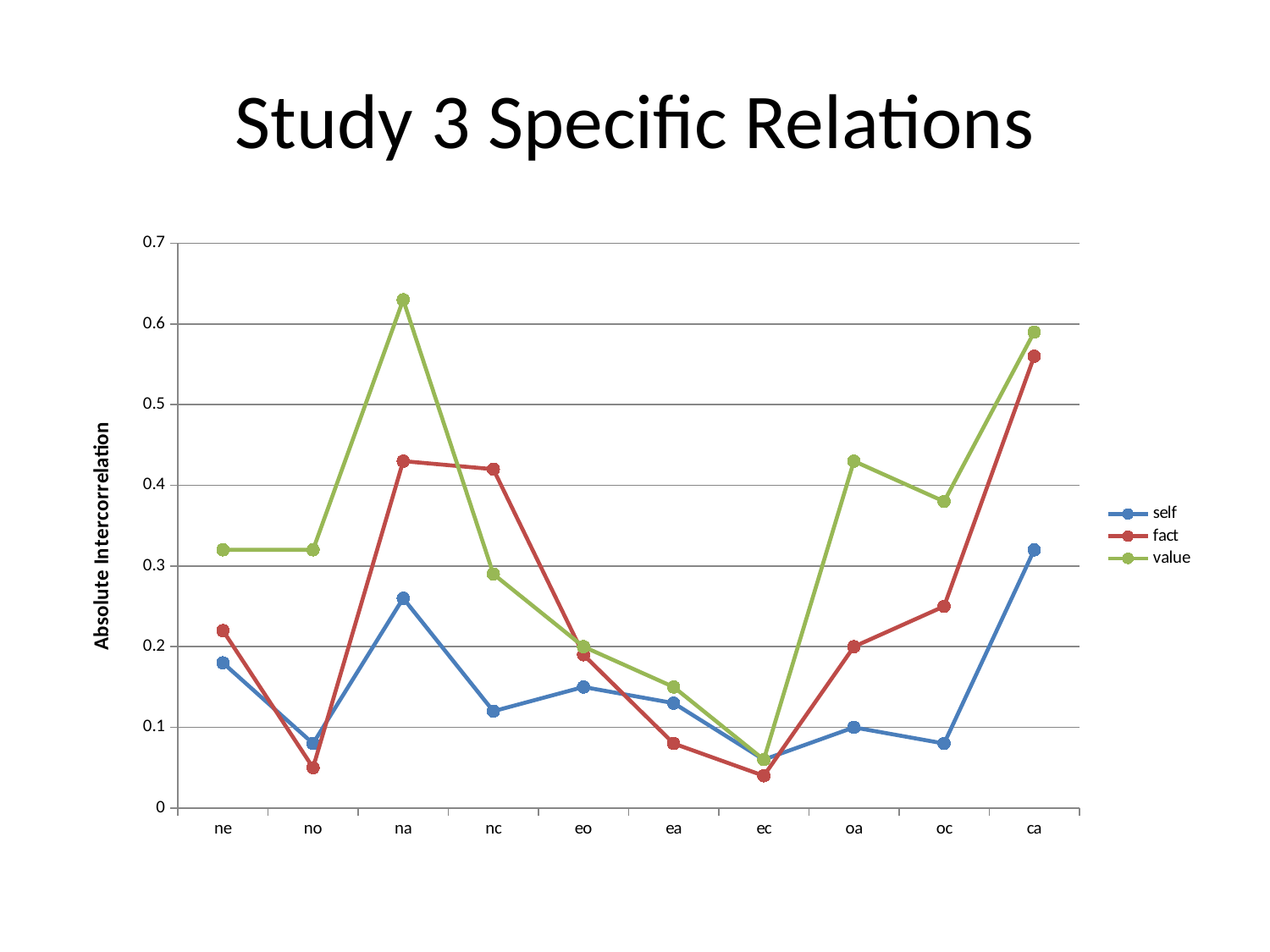
For which category does the value series reach its highest point? na How many categories are shown along the x axis? 10 What kind of chart is shown on the slide? line chart Is the fact series at no greater or less than 0.1? less How many series does the legend list? 3 Is the fact series at ca greater or less than 0.5? greater Is the value series at oa greater or less than 0.4? greater For which category is the fact series at its lowest? ec What is the label on the vertical axis? Absolute Intercorrelation Does the fact series rise or fall from na to ec? fall At nc, which series is higher: fact or value? fact